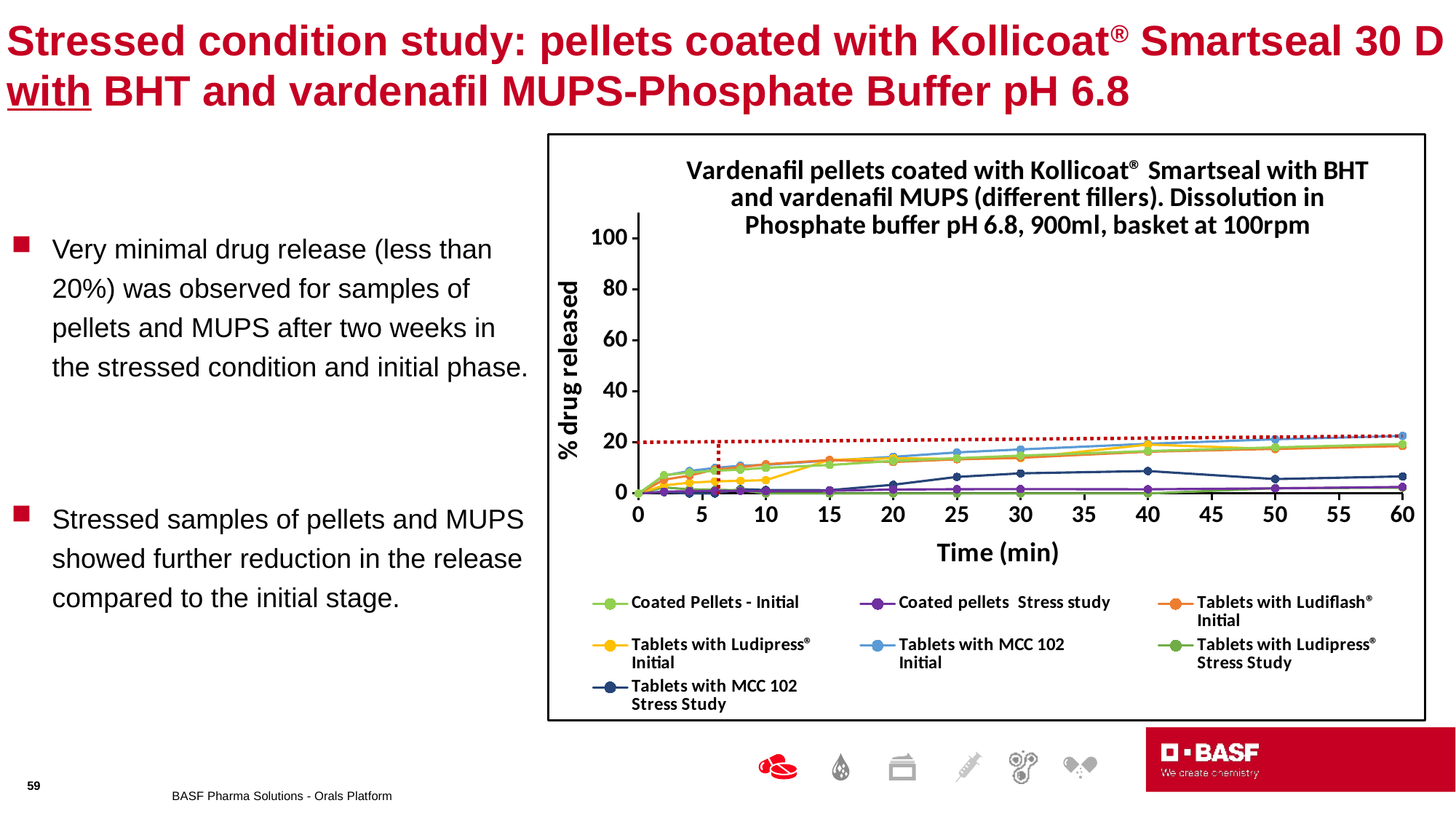
How many series does the chart legend list? 7 At 60 min, which is larger: Tablets with MCC 102 Initial or Coated pellets Stress study? Tablets with MCC 102 Initial What kind of chart is shown on the slide? line chart Is the value for Tablets with MCC 102 Initial at 60 min greater or less than 40? less What is the highest value shown on the y axis of the chart? 100 Is the value for Coated Pellets - Initial at 60 min greater or less than 10? greater Is the value for Coated pellets Stress study at 60 min greater or less than 20? less Does the Tablets with MCC 102 Initial series rise or fall from 0 to 60 min? rise At 60 min, which is larger: Tablets with Ludiflash Initial or Tablets with Ludipress Stress Study? Tablets with Ludiflash Initial What is the label of the x axis of the chart? Time (min) What is the label of the y axis of the chart? % drug released